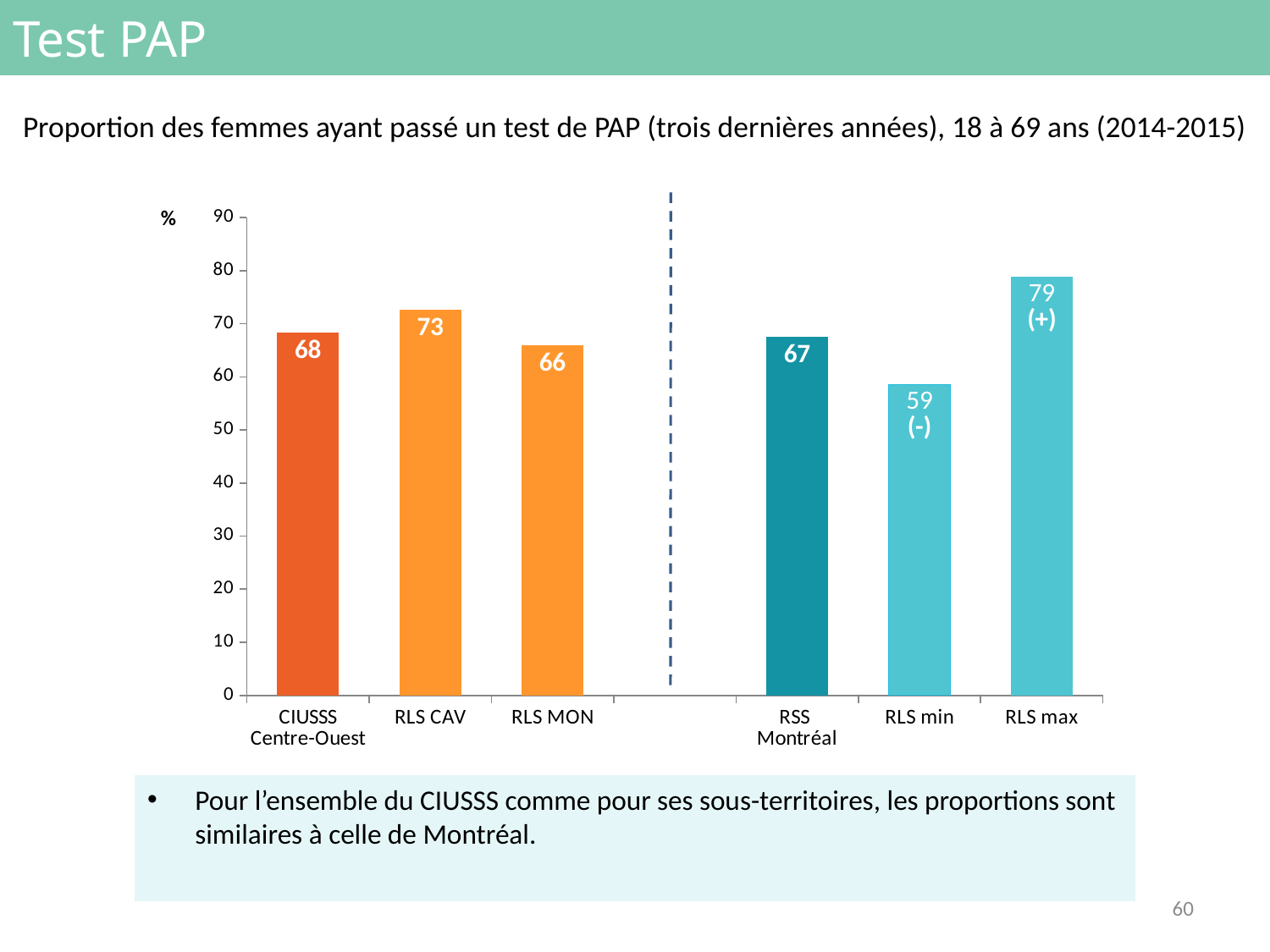
Which category has the lowest value? RLS min Which is larger, the value for CIUSSS Centre-Ouest or the value for RSS Montréal? CIUSSS Centre-Ouest What is the value for RLS CAV? 73 What is the value for RSS Montréal? 67 What is the value for CIUSSS Centre-Ouest? 68 What is the value for RLS min? 59 Which category has the highest value? RLS max What kind of chart is shown on the slide? bar chart Is the value for RLS max greater or less than 70? greater What is the difference between the values for RLS CAV and RLS MON? 7 What is the value for RLS MON? 66 How many bars are shown in the chart? 6